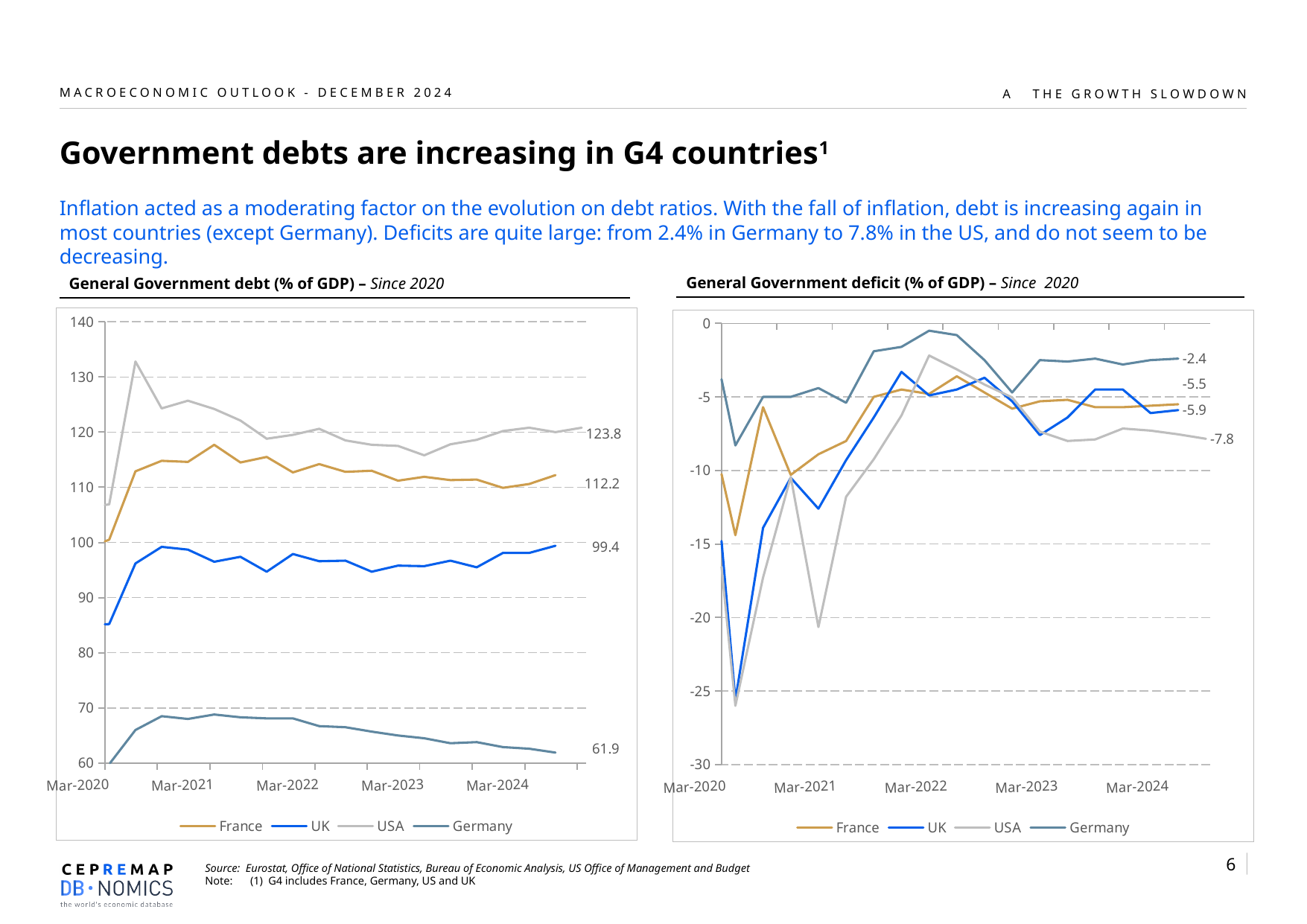
In the 'General Government deficit (% of GDP)' chart, which has the larger latest labelled deficit, France or the UK? UK In the 'General Government debt (% of GDP)' chart, is the value for the UK at Mar-2020 greater or less than 90? less In the 'General Government debt (% of GDP)' chart, what is the latest labelled value for Germany? 61.9 In the 'General Government debt (% of GDP)' chart, does the Germany line rise or fall from Mar-2022 to the end of the series? Fall In the 'General Government debt (% of GDP)' chart, what is the difference between the latest labelled values for France and the UK? 12.8 In the 'General Government debt (% of GDP)' chart, which country has the lowest latest labelled debt ratio? Germany In the 'General Government debt (% of GDP)' chart, which country has the highest latest labelled debt ratio? USA In the 'General Government deficit (% of GDP)' chart, what is the latest labelled value for the USA? -7.8 How many series does the legend of the 'General Government deficit (% of GDP)' chart list? 4 In the 'General Government debt (% of GDP)' chart, what is the latest labelled value for the USA? 123.8 What kind of chart is the 'General Government debt (% of GDP)' chart on the left? Line chart In the 'General Government deficit (% of GDP)' chart, what is the latest labelled value for Germany? -2.4